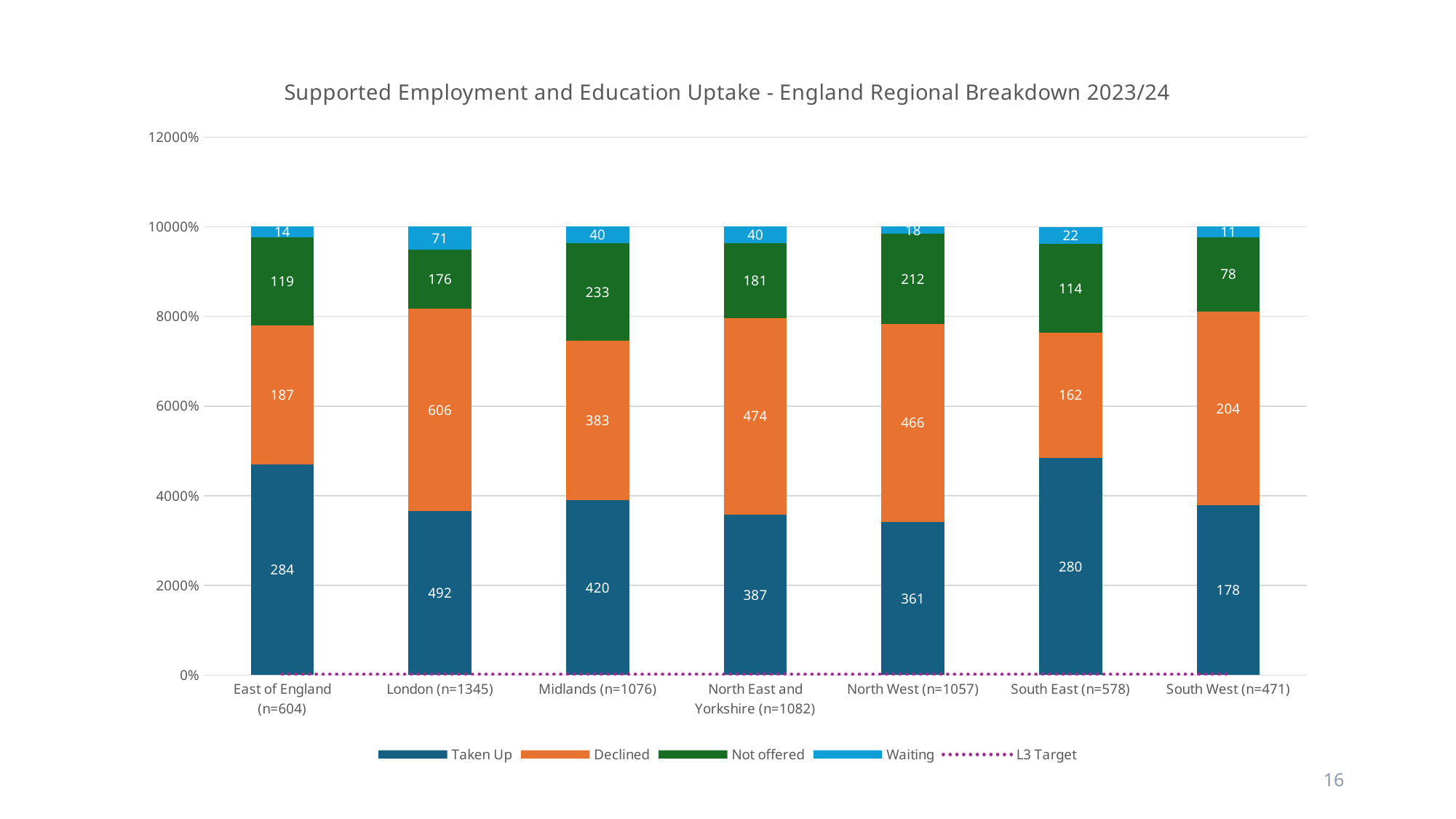
How many regions are shown on the x axis? 7 What kind of chart is shown on the slide? Stacked bar chart Which region has the lowest Waiting value? South West (n=471) What is the Not offered value for Midlands (n=1076)? 233 What is the total of the four labelled segments in the East of England (n=604) bar? 604 Which region has the highest Taken Up value? London (n=1345) Which is larger for North West (n=1057): the Declined value or the Taken Up value? Declined What is the Waiting value for South East (n=578)? 22 What is the difference between the Declined and Taken Up values for London (n=1345)? 114 How many entries does the legend list? 5 What is the Taken Up value for London (n=1345)? 492 What is the Declined value for North East and Yorkshire (n=1082)? 474